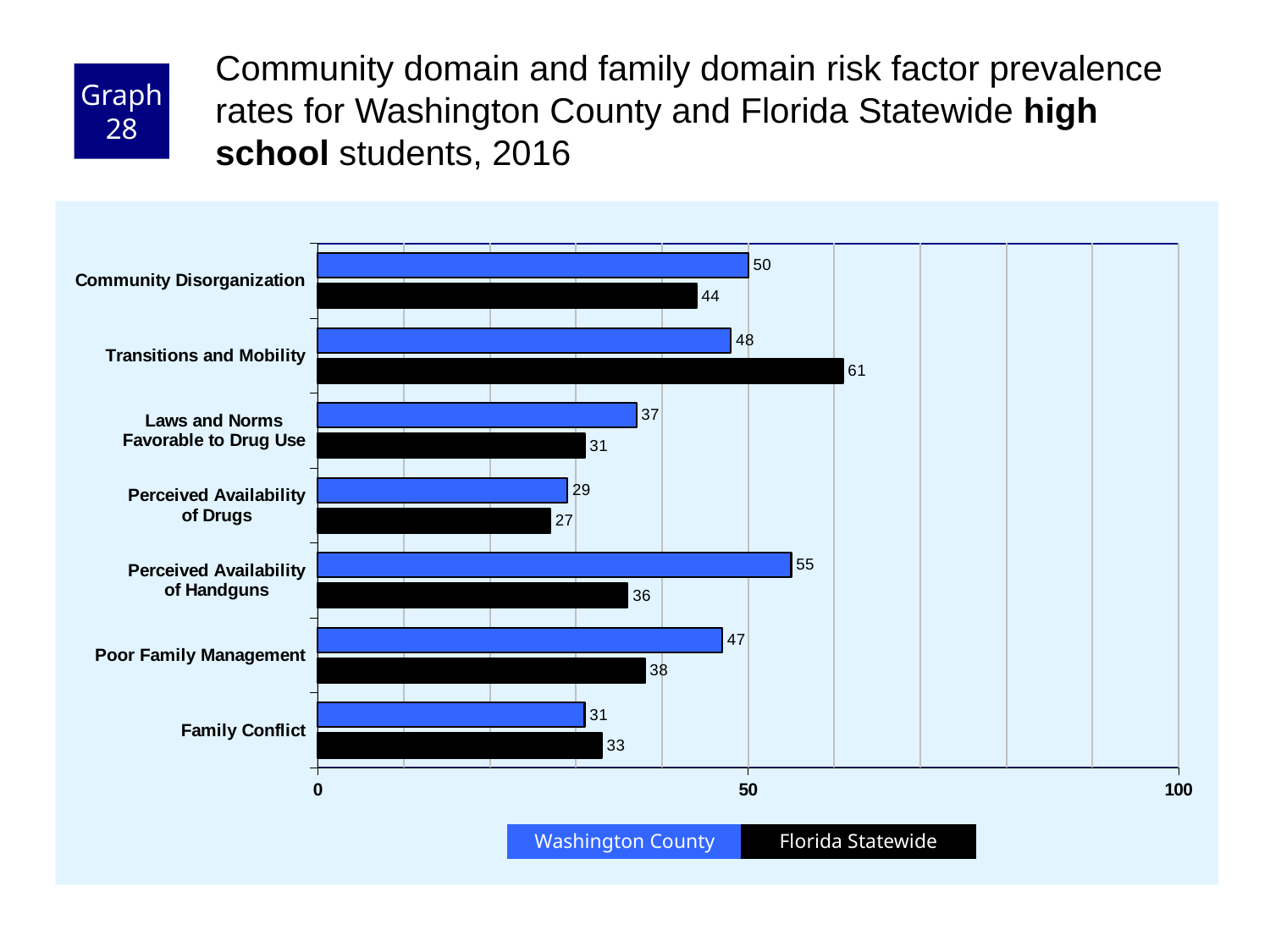
Which risk factor has the highest Washington County value? Perceived Availability of Handguns What is the Washington County value for Community Disorganization? 50 How many series does the legend list? 2 Which risk factor has the lowest Florida Statewide value? Perceived Availability of Drugs What is the difference between the Washington County and Florida Statewide values for Perceived Availability of Handguns? 19 How many risk factors are shown on the chart? 7 What is the Washington County value for Perceived Availability of Handguns? 55 What kind of chart is shown on the slide? bar chart What is the Florida Statewide value for Transitions and Mobility? 61 Which colour represents Florida Statewide in the chart? black Is the Florida Statewide value for Transitions and Mobility greater or less than 50? greater For Family Conflict, which is larger: the Washington County value or the Florida Statewide value? Florida Statewide